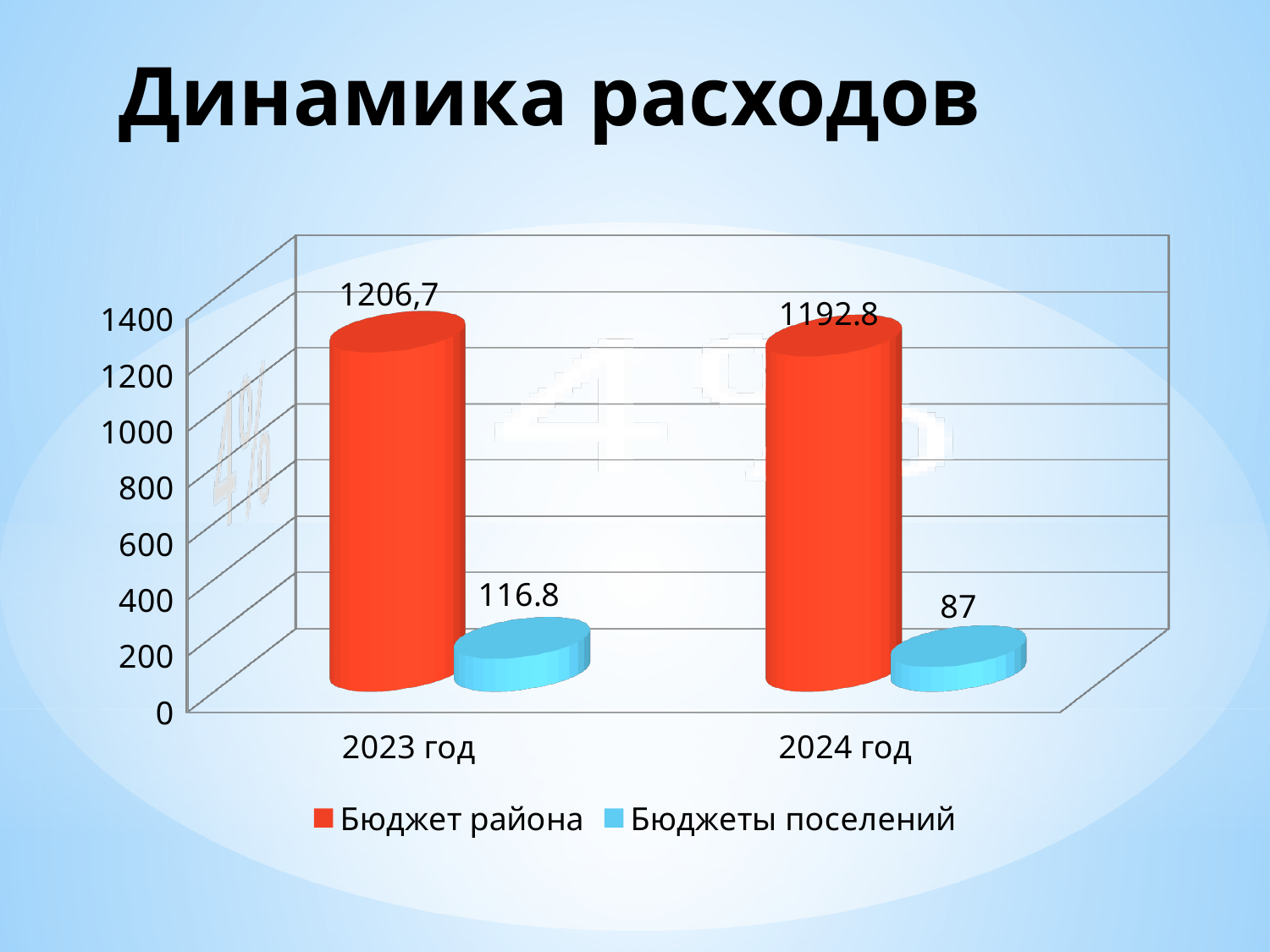
How many series does the legend list? 2 What is the value for Бюджеты поселений in 2024 год? 87 What is the value for Бюджеты поселений in 2023 год? 116.8 How many categories are shown on the x axis? 2 In which year is the value for Бюджеты поселений lowest? 2024 год Does the value for Бюджет района rise or fall from 2023 год to 2024 год? fall What is the difference between the Бюджеты поселений values for 2023 год and 2024 год? 29.8 What kind of chart is shown on the slide? bar chart Is the value for Бюджеты поселений in 2024 год greater or less than 200? less Which series has the higher value in 2024 год, Бюджет района or Бюджеты поселений? Бюджет района What is the value for Бюджет района in 2023 год? 1206,7 What is the value for Бюджет района in 2024 год? 1192.8